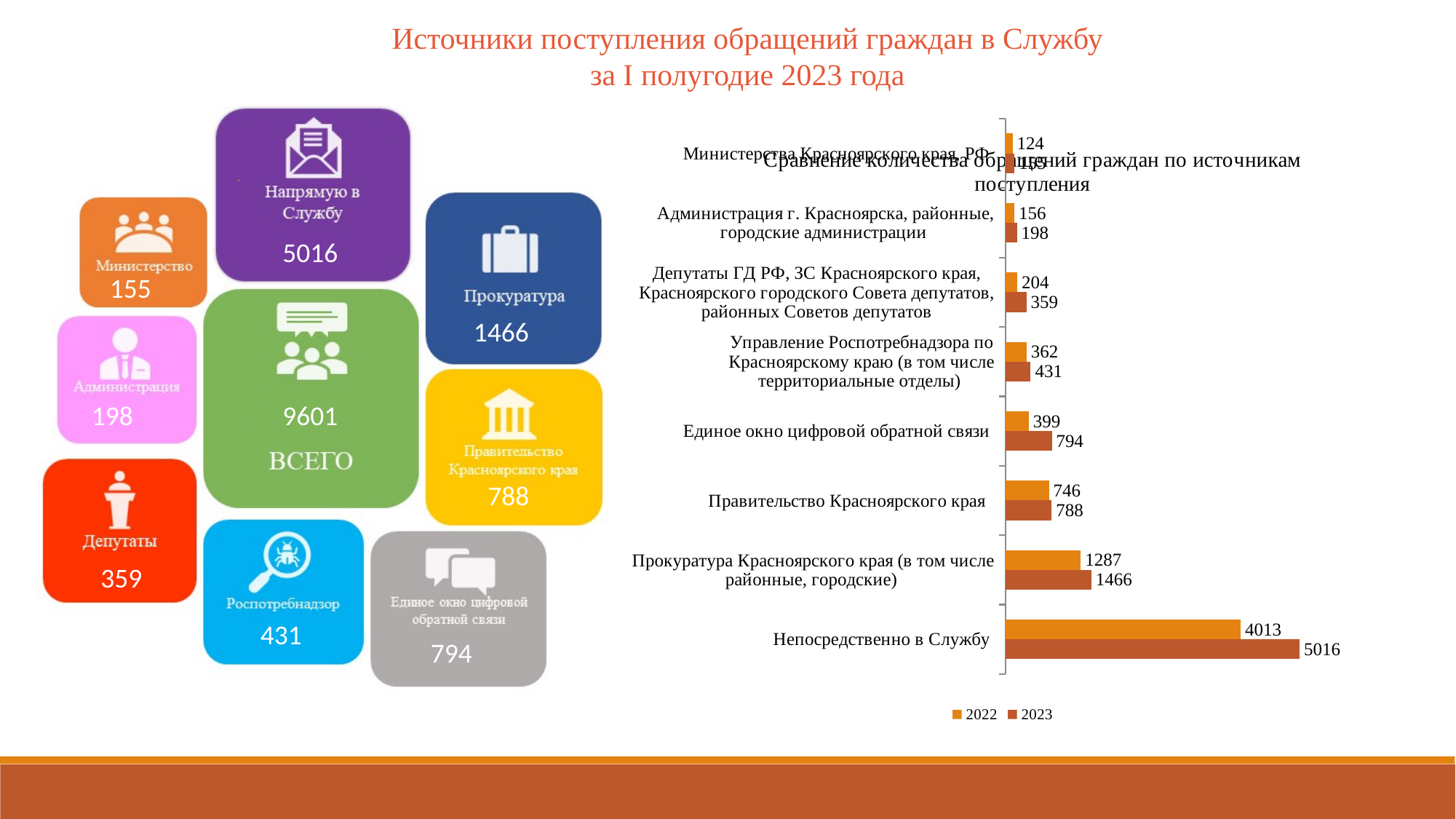
What is the 2022 value for 'Единое окно цифровой обратной связи' in the bar chart? 399 How many series does the legend of the bar chart list? 2 What kind of chart is shown on the right side of the slide? bar chart What is the 2023 value for 'Непосредственно в Службу' in the bar chart? 5016 Which category has the highest 2023 value in the bar chart? Непосредственно в Службу In the bar chart, is the 2022 value or the 2023 value larger for 'Единое окно цифровой обратной связи'? 2023 What is the difference between the 2023 and 2022 values for 'Непосредственно в Службу' in the bar chart? 1003 Which years are listed in the legend of the bar chart? 2022 and 2023 How many categories are shown in the bar chart? 8 What is the 2023 value for 'Прокуратура Красноярского края (в том числе районные, городские)' in the bar chart? 1466 What is the 2022 value for 'Правительство Красноярского края' in the bar chart? 746 Which category has the lowest 2022 value in the bar chart? Министерства Красноярского края, РФ